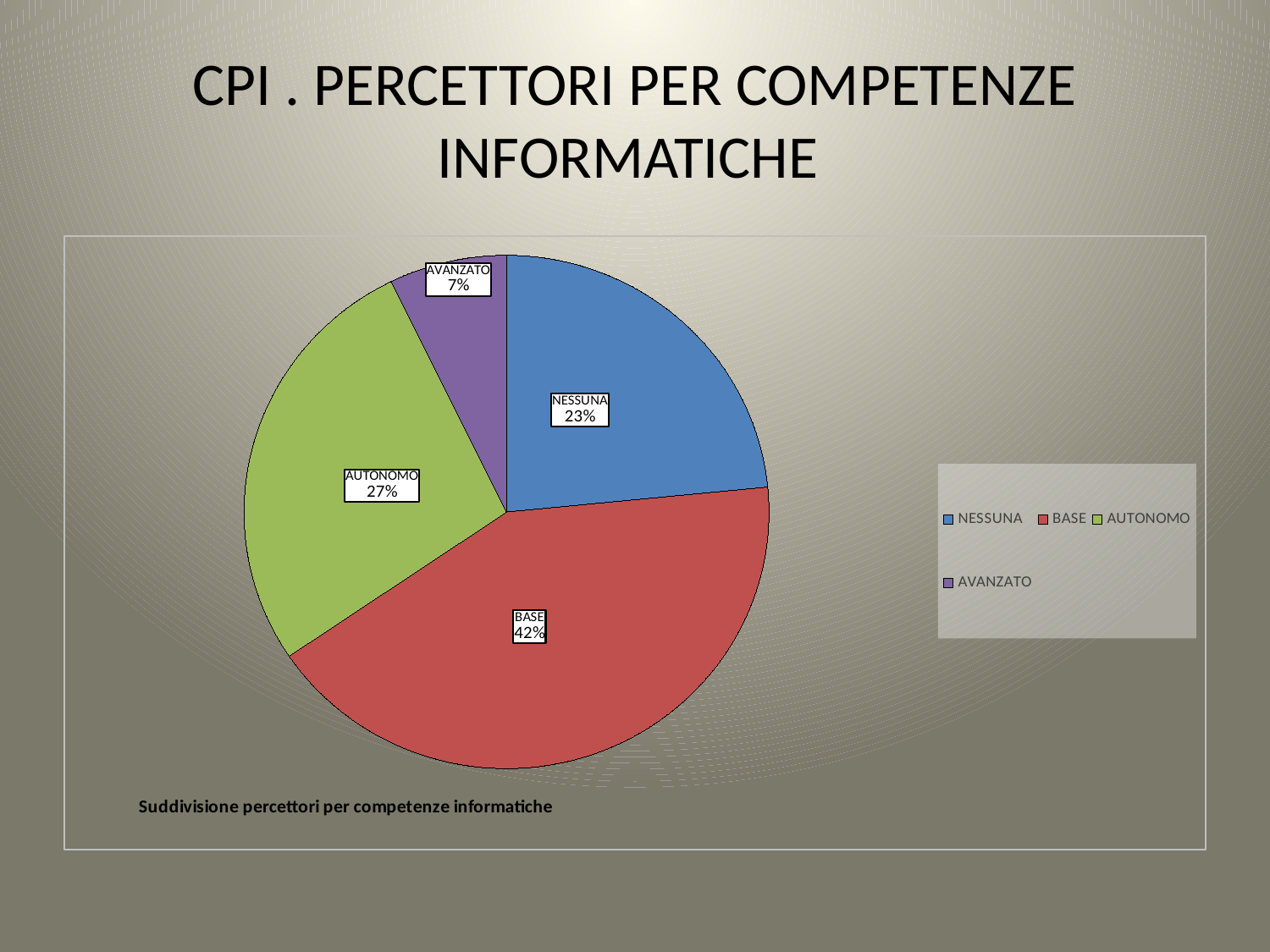
What share of the pie does NESSUNA represent? 23% What is the caption printed below the pie chart? Suddivisione percettori per competenze informatiche Which category has the smallest slice of the pie? AVANZATO Which is larger, the share for AUTONOMO or the share for NESSUNA? AUTONOMO What is the difference in percentage points between BASE and NESSUNA? 19 How many entries does the legend list? 4 How many slices does the pie chart have? 4 What share of the pie does AVANZATO represent? 7% What share of the pie does BASE represent? 42% What kind of chart is shown on the slide? pie chart Which category has the largest slice of the pie? BASE